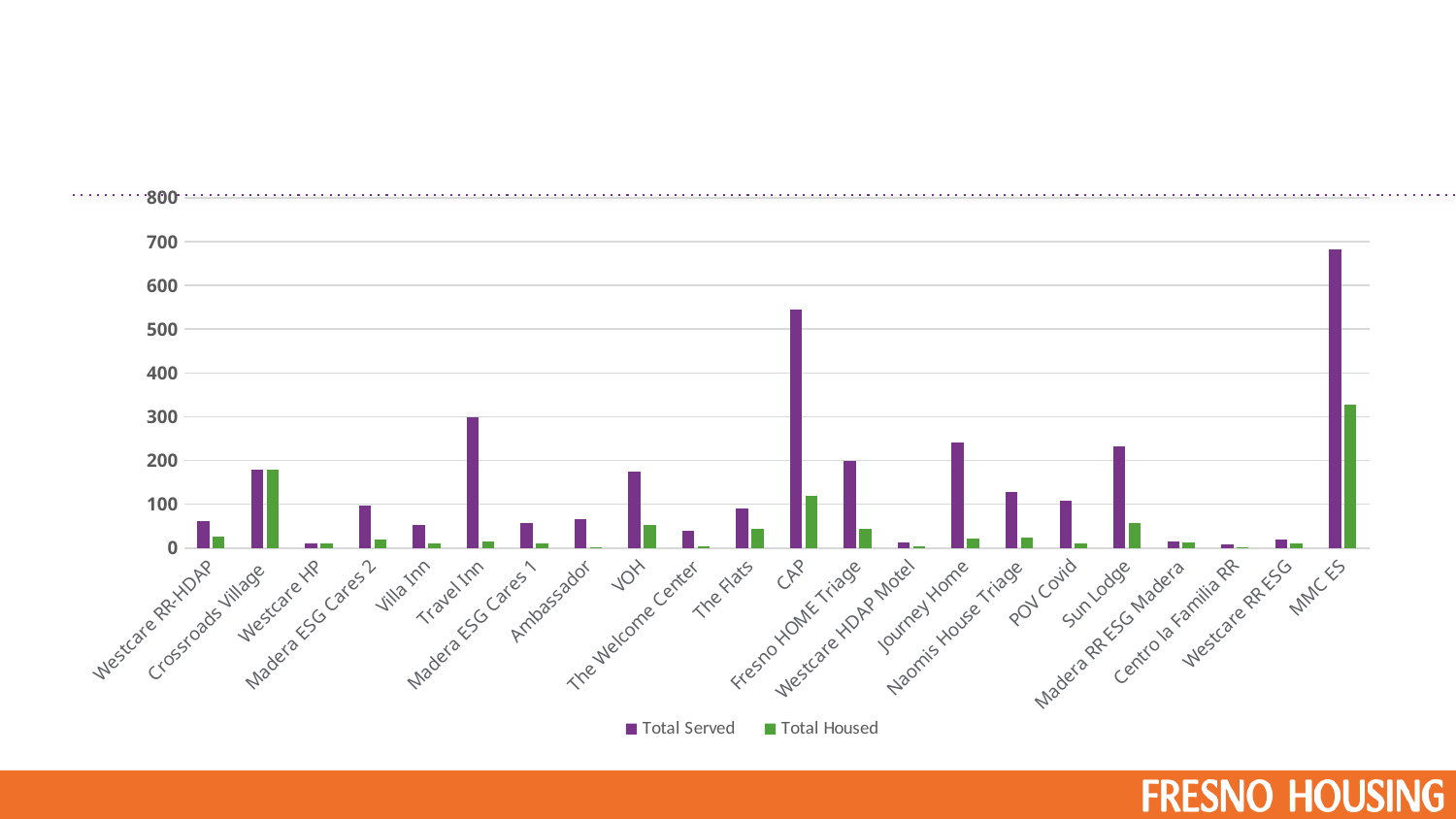
Which has a larger Total Served value, CAP or Sun Lodge? CAP Is the Total Served value for CAP greater or less than 500? greater Is the Total Served value for Crossroads Village greater or less than 200? less Which colour represents the Total Housed series in the legend? Green How many series does the legend list? 2 How many categories are shown on the x axis? 22 What kind of chart is shown on the slide? Bar chart Which category has the highest Total Served value? MMC ES Is the Total Housed value for MMC ES greater or less than 300? greater Which category has the highest Total Housed value? MMC ES Which has a larger Total Housed value, Crossroads Village or CAP? Crossroads Village